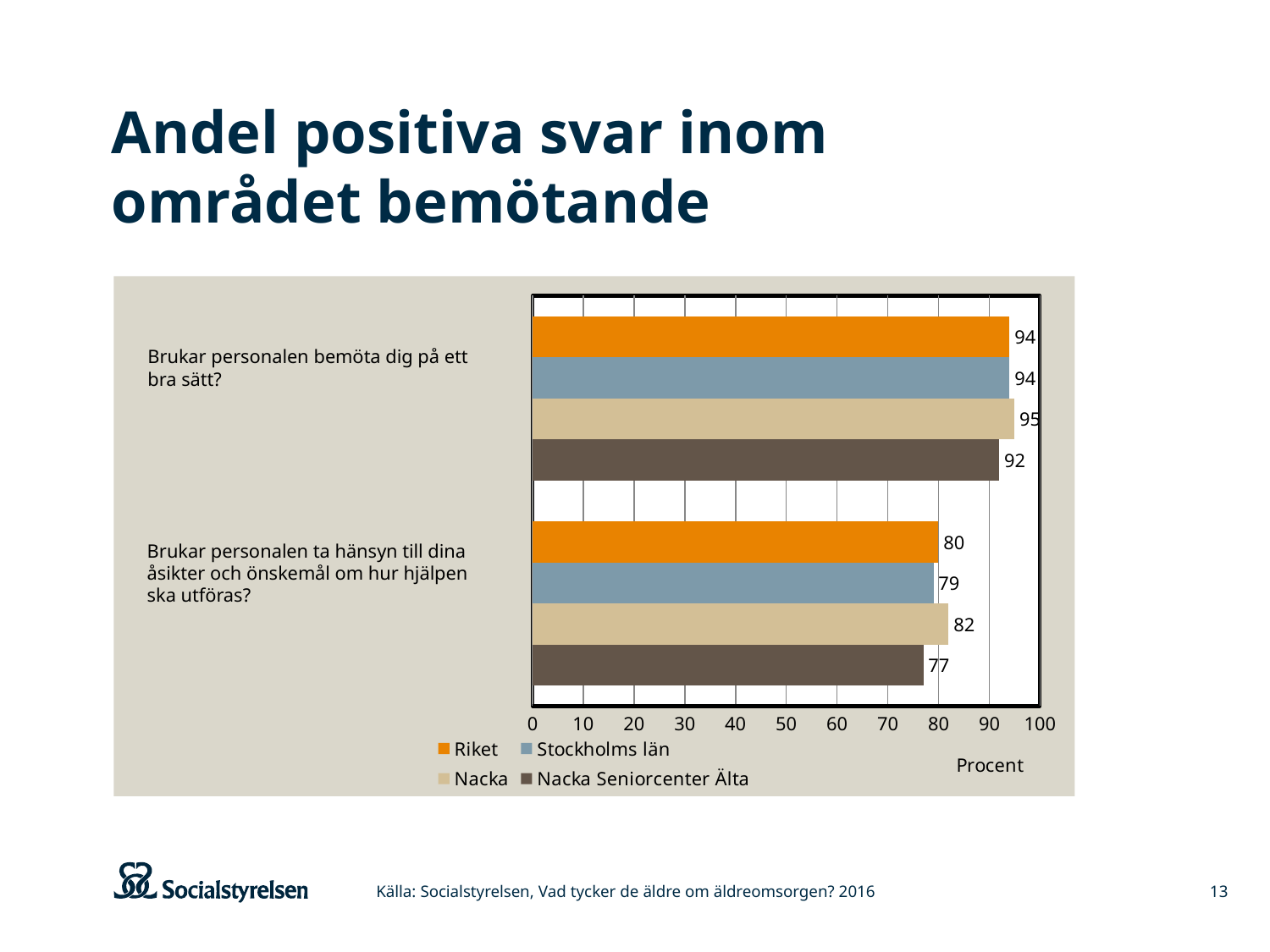
How many questions (categories) are shown on the chart? 2 How many series does the legend list? 4 Which series has the lowest value for the question "Brukar personalen ta hänsyn till dina åsikter och önskemål om hur hjälpen ska utföras?" Nacka Seniorcenter Älta What is the label on the horizontal axis of the chart? Procent What is the value for Nacka Seniorcenter Älta for the question "Brukar personalen ta hänsyn till dina åsikter och önskemål om hur hjälpen ska utföras?" 77 Which is larger for the question "Brukar personalen bemöta dig på ett bra sätt?": the Riket value or the Nacka Seniorcenter Älta value? Riket What is the value for Nacka for the question "Brukar personalen bemöta dig på ett bra sätt?" 95 Which series has the highest value for the question "Brukar personalen bemöta dig på ett bra sätt?" Nacka What type of chart is shown on the slide? bar chart What is the value for Stockholms län for the question "Brukar personalen bemöta dig på ett bra sätt?" 94 What is the difference between the Nacka value and the Nacka Seniorcenter Älta value for the question "Brukar personalen ta hänsyn till dina åsikter och önskemål om hur hjälpen ska utföras?" 5 What is the value for Riket for the question "Brukar personalen ta hänsyn till dina åsikter och önskemål om hur hjälpen ska utföras?" 80